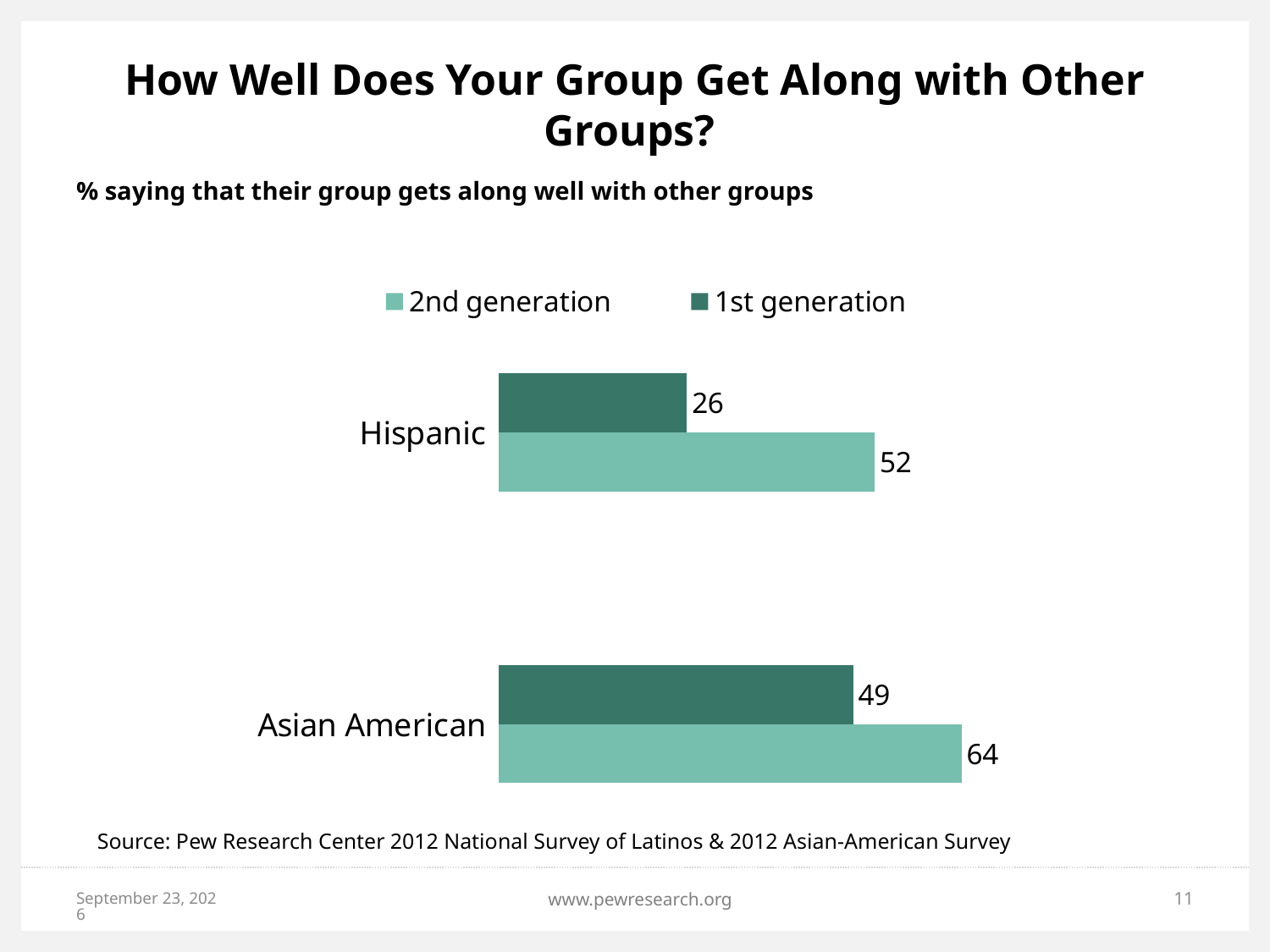
How many series does the legend list? 2 What kind of chart is shown on the slide? Bar chart What is the value for 2nd generation Hispanics? 52 Which group and generation has the highest value on the chart? 2nd generation Asian American What is the value for 1st generation Asian Americans? 49 How many groups are shown on the chart? 2 What is the value for 2nd generation Asian Americans? 64 What is the difference between the 2nd generation and 1st generation values for Hispanics? 26 What is the difference between the 2nd generation and 1st generation values for Asian Americans? 15 Which is larger: the 1st generation value for Asian Americans or the 2nd generation value for Hispanics? 2nd generation value for Hispanics Which group and generation has the lowest value on the chart? 1st generation Hispanic What is the value for 1st generation Hispanics? 26